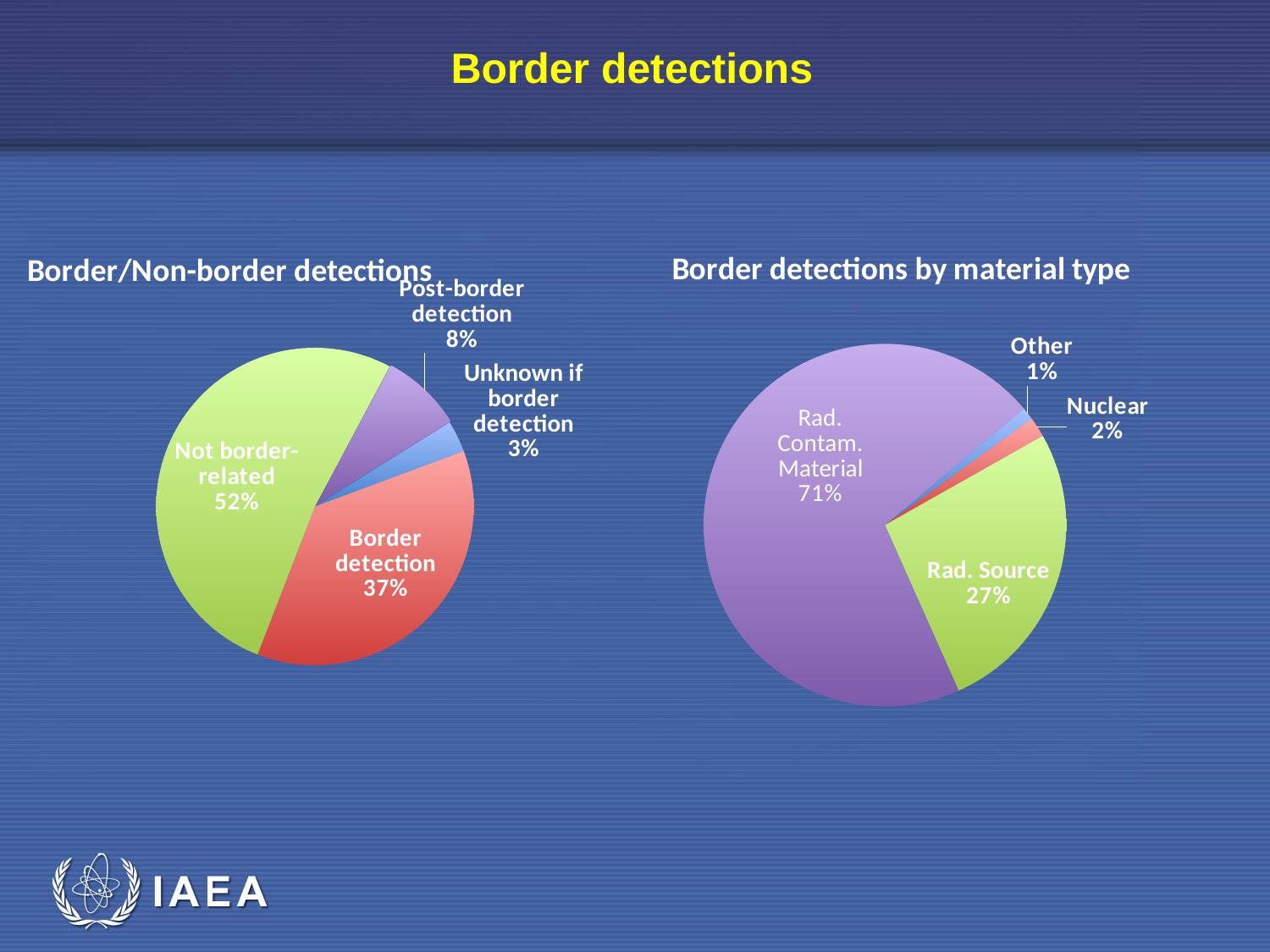
In the 'Border/Non-border detections' chart, which category has the largest share? Not border-related In the 'Border detections by material type' chart, what share is 'Rad. Contam. Material'? 71% In the 'Border detections by material type' chart, what share is 'Nuclear'? 2% In the 'Border detections by material type' chart, which category has the smallest share? Other In the 'Border detections by material type' chart, which is larger, 'Rad. Source' or 'Nuclear'? Rad. Source How many slices does the 'Border/Non-border detections' pie chart have? 4 In the 'Border/Non-border detections' chart, what share is 'Post-border detection'? 8% In the 'Border/Non-border detections' chart, what share is 'Border detection'? 37% In the 'Border/Non-border detections' chart, what is the difference between 'Not border-related' and 'Border detection'? 15% In the 'Border/Non-border detections' chart, what share is 'Not border-related'? 52% In the 'Border/Non-border detections' chart, which category has the smallest share? Unknown if border detection What type of chart is used for 'Border detections by material type'? Pie chart